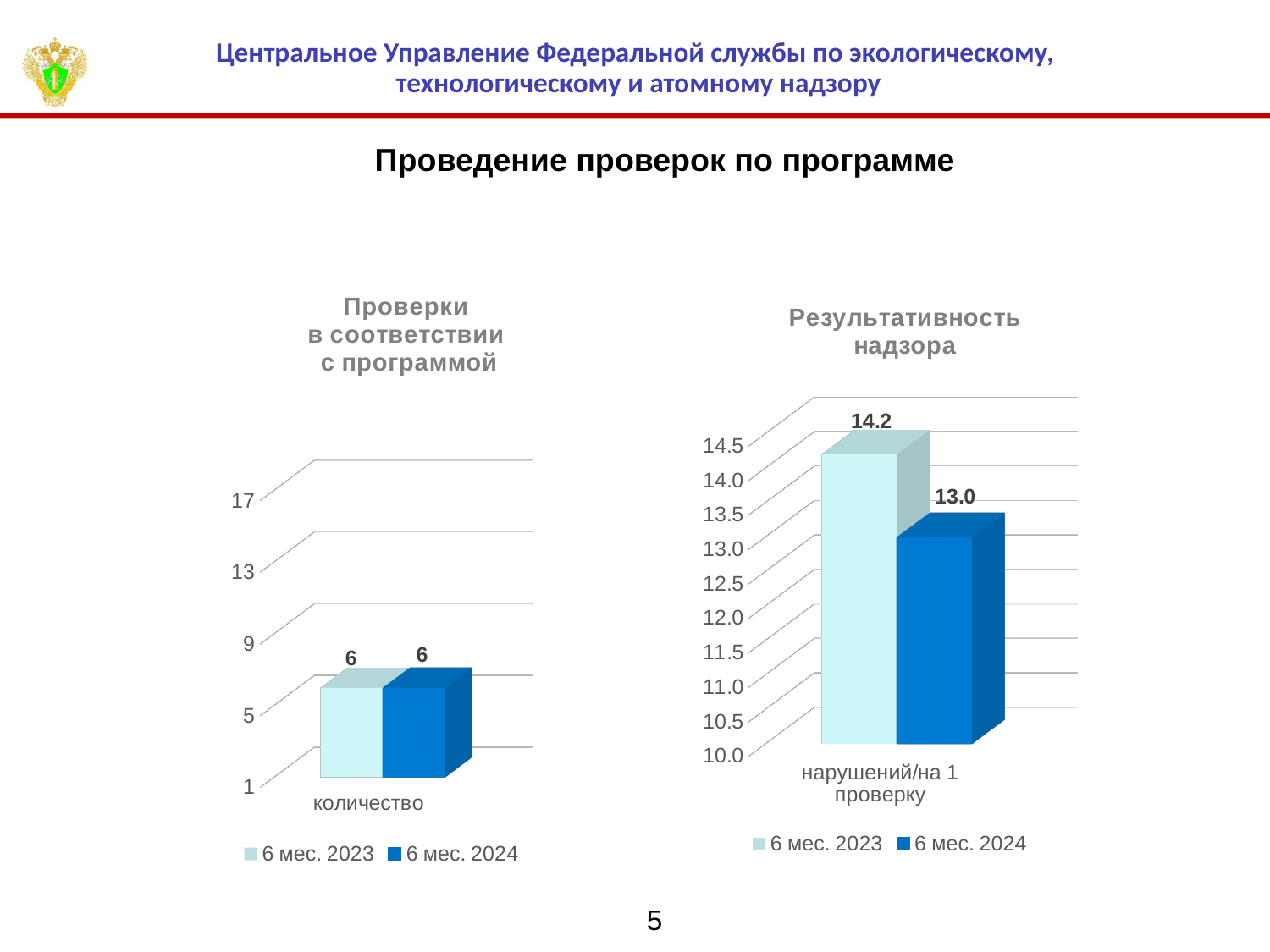
In the chart titled "Проверки в соответствии с программой", what is the value for 6 мес. 2024? 6 What kind of chart is the chart titled "Проверки в соответствии с программой"? bar chart What is the category label on the x axis of the chart titled "Результативность надзора"? нарушений/на 1 проверку In the chart titled "Результативность надзора", what is the value for 6 мес. 2024? 13.0 In the chart titled "Результативность надзора", what is the difference between the 6 мес. 2023 value and the 6 мес. 2024 value? 1.2 In the chart titled "Проверки в соответствии с программой", what is the value for 6 мес. 2023? 6 In the chart titled "Результативность надзора", which series has the lower value? 6 мес. 2024 In the chart titled "Результативность надзора", is the value for 6 мес. 2024 greater or less than 14.0? less How many series does the legend of the chart titled "Результативность надзора" list? 2 In the chart titled "Результативность надзора", which series has the higher value? 6 мес. 2023 In the chart titled "Результативность надзора", what is the value for 6 мес. 2023? 14.2 In the chart titled "Проверки в соответствии с программой", is the value for 6 мес. 2023 greater or less than 9? less